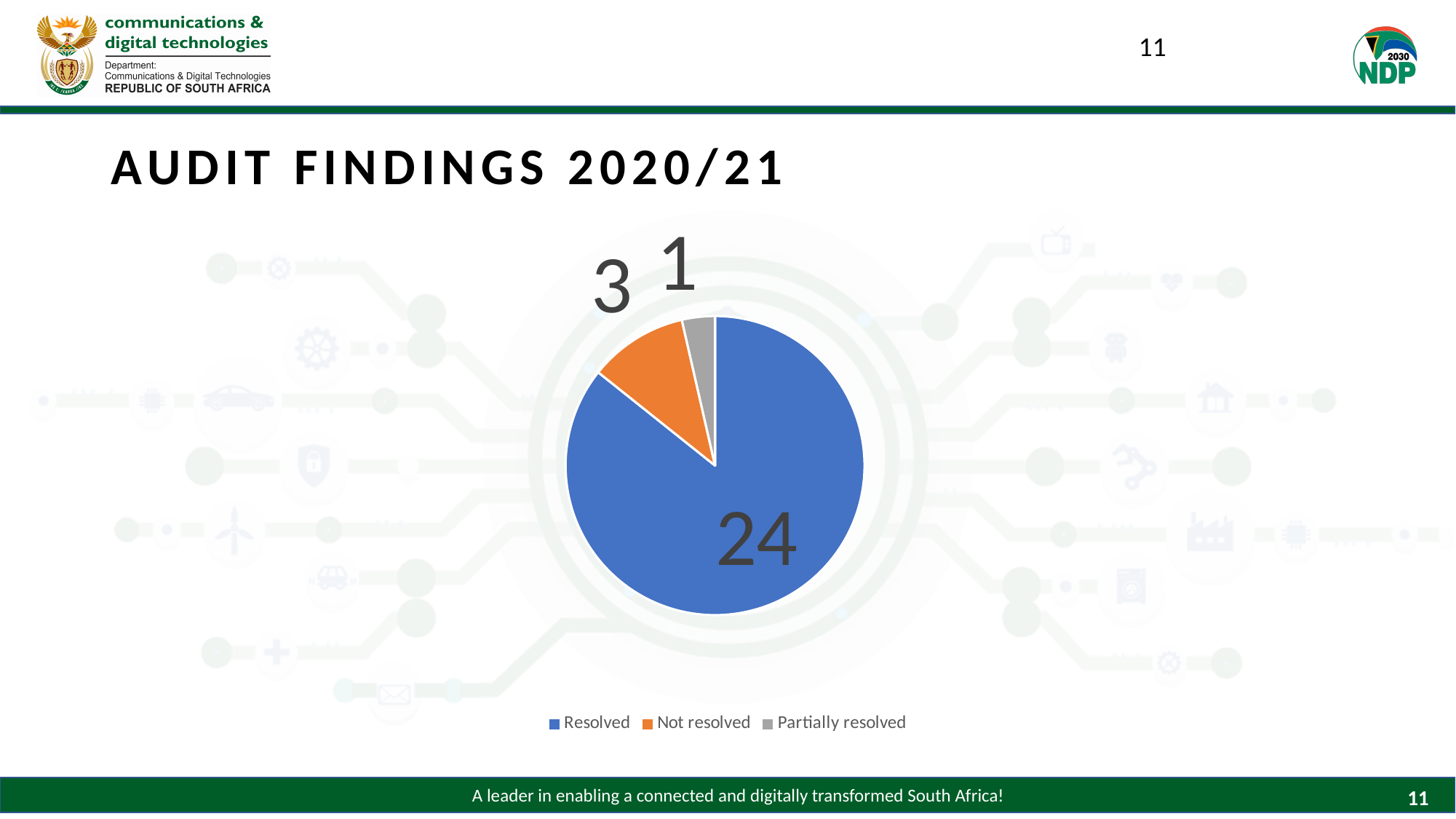
Which category has the largest slice of the pie? Resolved How many audit findings were not resolved? 3 What is the difference between the number of resolved and not resolved findings? 21 What is the total number of audit findings shown in the pie chart? 28 What kind of chart is shown on the slide? pie chart How many categories does the pie chart show? 3 How many audit findings were resolved? 24 What is the title of the slide containing the chart? AUDIT FINDINGS 2020/21 Which category has the smallest slice of the pie? Partially resolved How many audit findings were partially resolved? 1 Which is larger, the number of not resolved findings or the number of partially resolved findings? Not resolved What colour is the Not resolved slice? orange